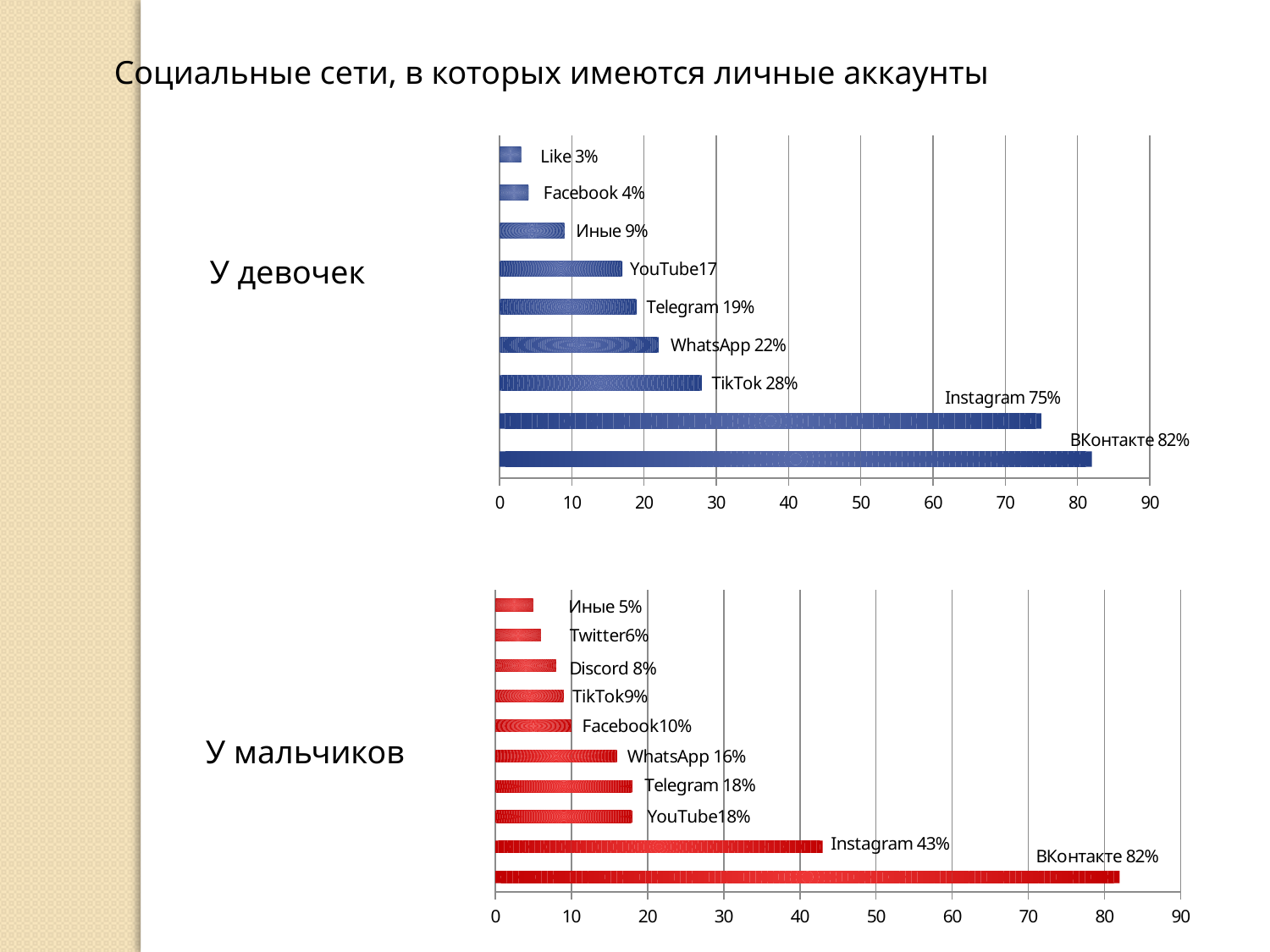
In the 'У девочек' chart, which social network has the highest value? ВКонтакте In the 'У мальчиков' chart, which social network has the lowest value? Иные How many social networks are shown in the 'У мальчиков' chart? 10 In the 'У мальчиков' chart, which is larger, Telegram or Discord? Telegram In the 'У девочек' chart, which social network has the lowest value? Like In the 'У девочек' chart, what is the difference between ВКонтакте and Instagram? 7% In the 'У девочек' chart, what is the value for TikTok? 28% In the 'У девочек' chart, what is the value for Instagram? 75% In the 'У мальчиков' chart, what is the difference between ВКонтакте and Instagram? 39% In the 'У мальчиков' chart, what is the value for WhatsApp? 16% In the 'У мальчиков' chart, what is the value for Instagram? 43% What type of chart is the 'У девочек' chart? Bar chart